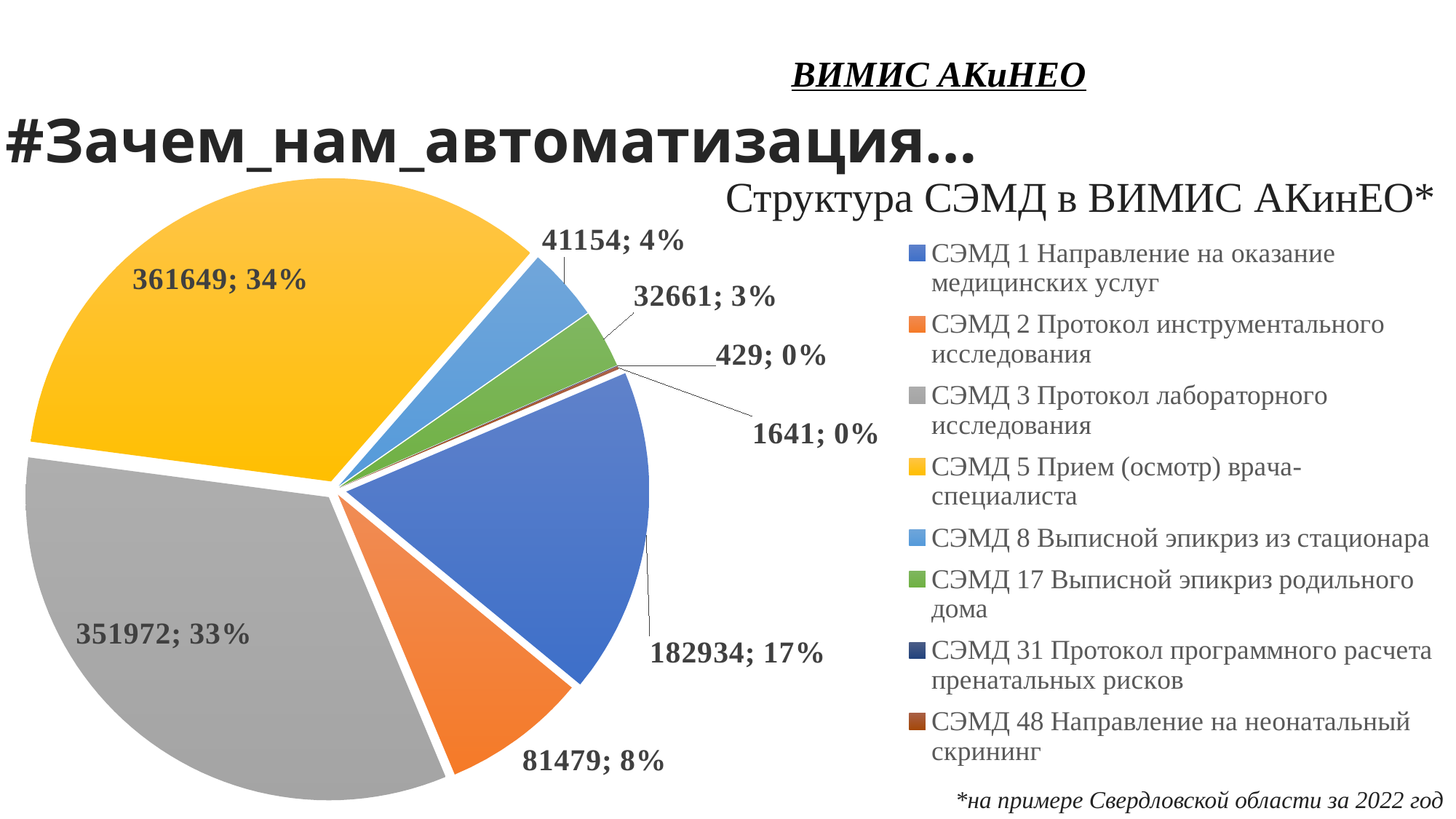
What is the difference between the values for СЭМД 5 and СЭМД 3? 9677 What value and share are shown for СЭМД 5 Прием (осмотр) врача-специалиста? 361649; 34% How many categories does the legend list? 8 Which category has the largest slice of the pie? СЭМД 5 Прием (осмотр) врача-специалиста What value and share are shown for СЭМД 17 Выписной эпикриз родильного дома? 32661; 3% What value and share are shown for СЭМД 1 Направление на оказание медицинских услуг? 182934; 17% What value and share are shown for СЭМД 8 Выписной эпикриз из стационара? 41154; 4% What is the title of the chart? Структура СЭМД в ВИМИС АКинЕО* What is the smallest value labelled on the pie chart? 429 What kind of chart is shown on the slide? pie chart What value and share are shown for СЭМД 3 Протокол лабораторного исследования? 351972; 33% What value and share are shown for СЭМД 2 Протокол инструментального исследования? 81479; 8%